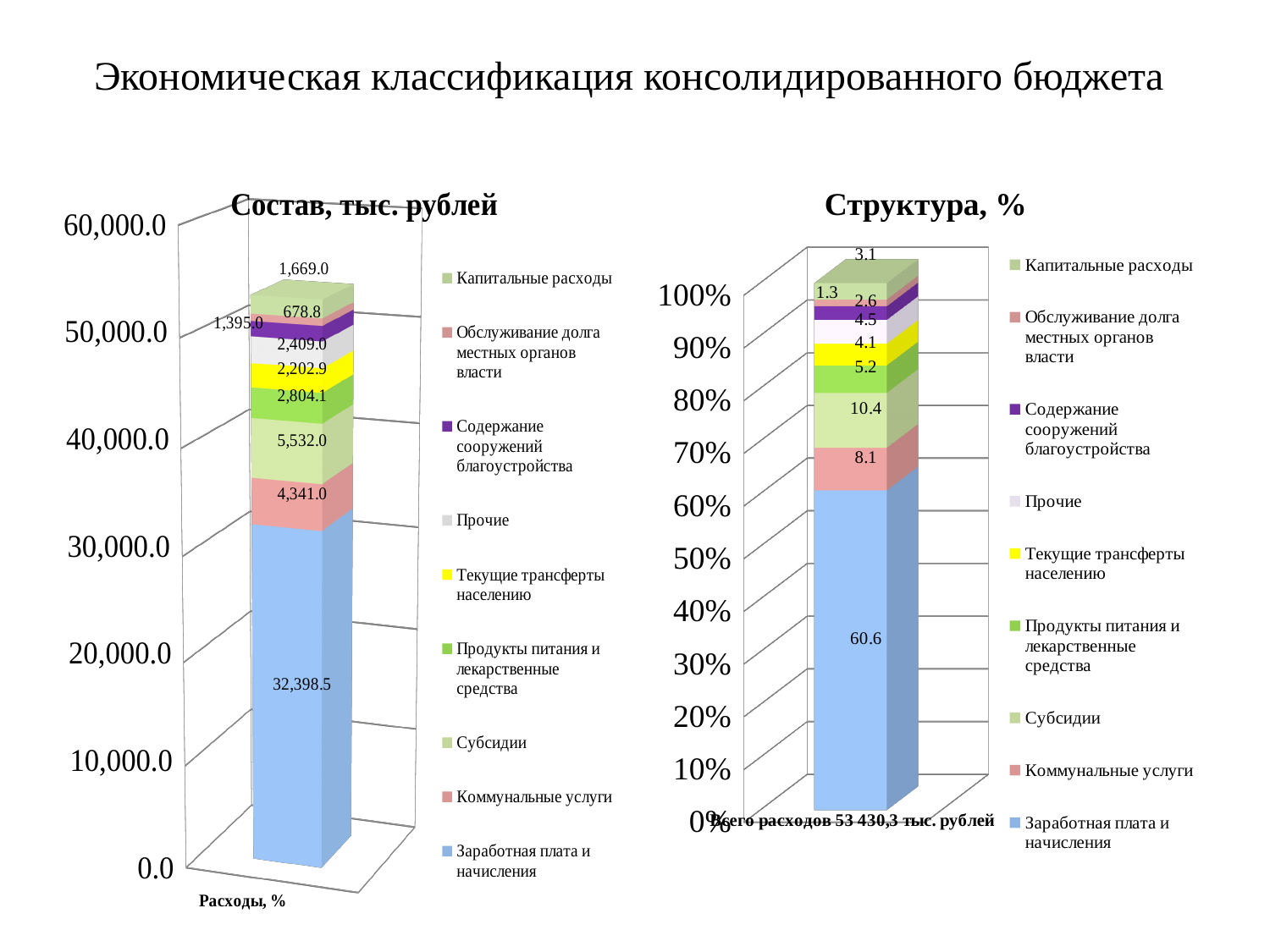
On the chart titled "Структура, %", which series has the largest share? Заработная плата и начисления On the chart titled "Состав, тыс. рублей", what is the value for Заработная плата и начисления? 32,398.5 On the chart titled "Состав, тыс. рублей", what is the difference between Субсидии and Коммунальные услуги? 1,191.0 How many series does the legend of the chart titled "Структура, %" list? 9 On the chart titled "Структура, %", what is the share for Заработная плата и начисления? 60.6 What kind of chart is the chart titled "Состав, тыс. рублей"? Stacked bar chart On the chart titled "Структура, %", what is the share for Капитальные расходы? 3.1 On the chart titled "Состав, тыс. рублей", which is larger: Прочие or Текущие трансферты населению? Прочие What total expenditure is stated below the chart titled "Структура, %"? 53 430,3 тыс. рублей On the chart titled "Состав, тыс. рублей", which series has the smallest value? Обслуживание долга местных органов власти On the chart titled "Состав, тыс. рублей", what is the value for Обслуживание долга местных органов власти? 678.8 On the chart titled "Состав, тыс. рублей", what is the value for Субсидии? 5,532.0